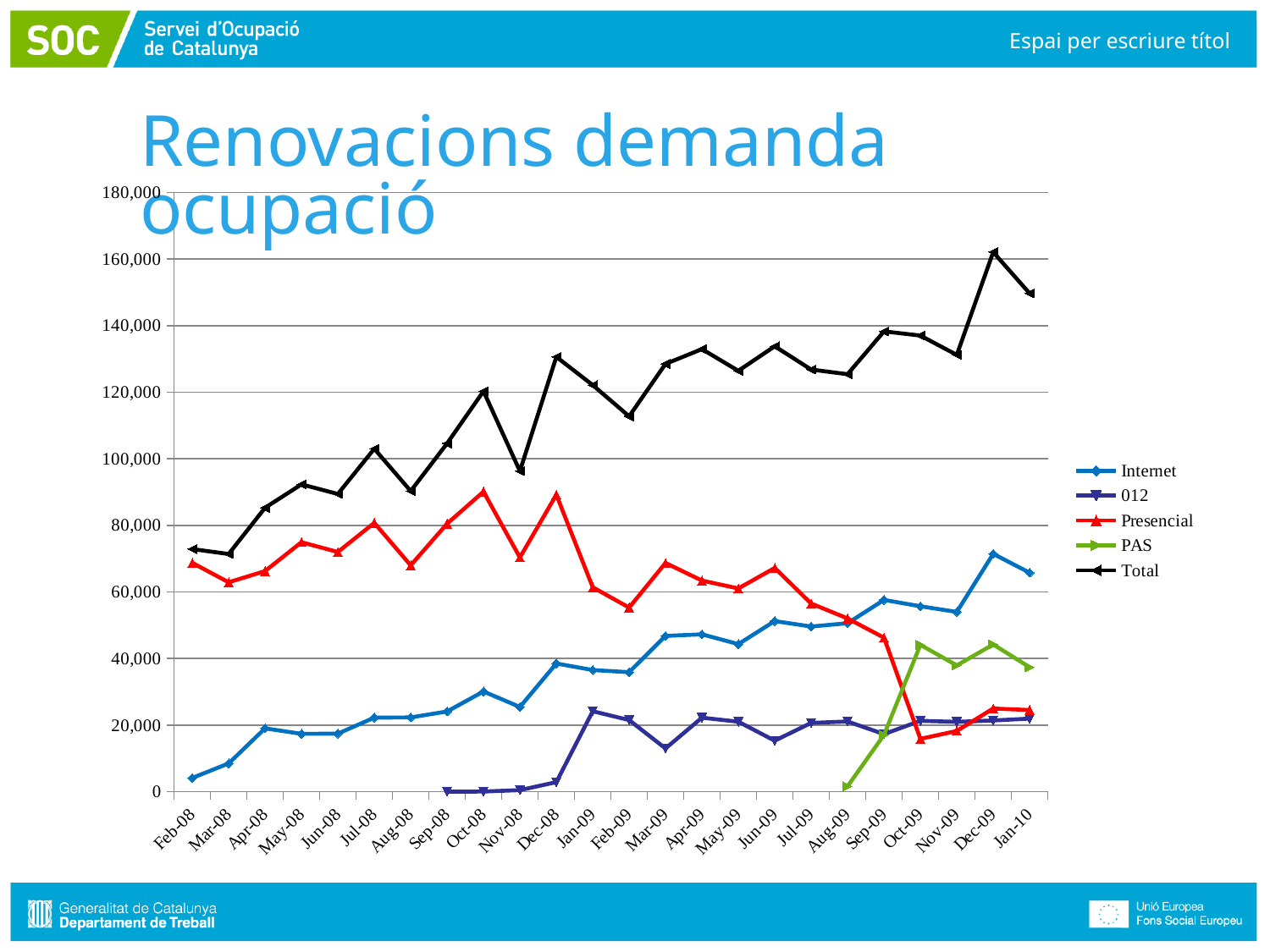
Is the value for Presencial in Oct-09 greater or less than 20,000? less How many months are shown along the x axis? 24 Does the Total series generally rise or fall from Feb-08 to Jan-10? Rise How many series does the legend list? 5 Is the value for Internet in Dec-09 greater or less than 60,000? greater In Jan-10, which series has the larger value, Internet or Presencial? Internet In which month is the Internet series at its lowest value? Feb-08 Is the value for Total in Feb-08 greater or less than 80,000? less What kind of chart is shown on the slide? Line chart In Feb-08, which series has the larger value, Presencial or Internet? Presencial Which series is drawn in green? PAS In which month does the Total series reach its highest value? Dec-09